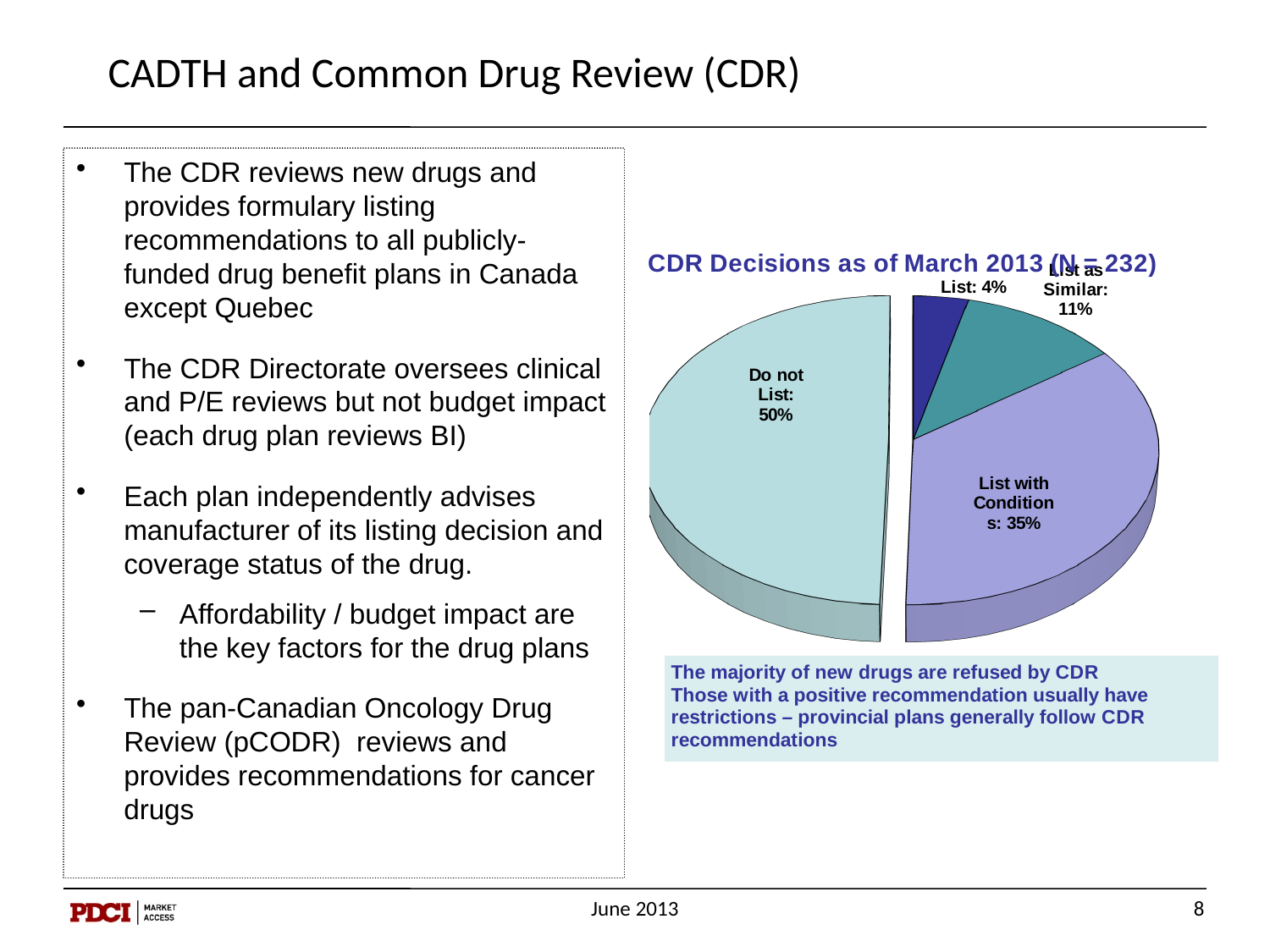
Which is larger, the share for "List as Similar" or the share for "List"? List as Similar What share of CDR decisions is "List with Conditions"? 35% How many slices does the pie chart have? 4 What is the difference in percentage points between "Do not List" and "List with Conditions"? 15 percentage points What type of chart is shown on the slide? Pie chart What is the total number of decisions (N) stated in the chart title? 232 What share of CDR decisions is "List"? 4% Which decision category has the largest slice of the pie? Do not List What is the title of the chart? CDR Decisions as of March 2013 (N = 232) What share of CDR decisions is "Do not List"? 50% Which decision category has the smallest slice of the pie? List